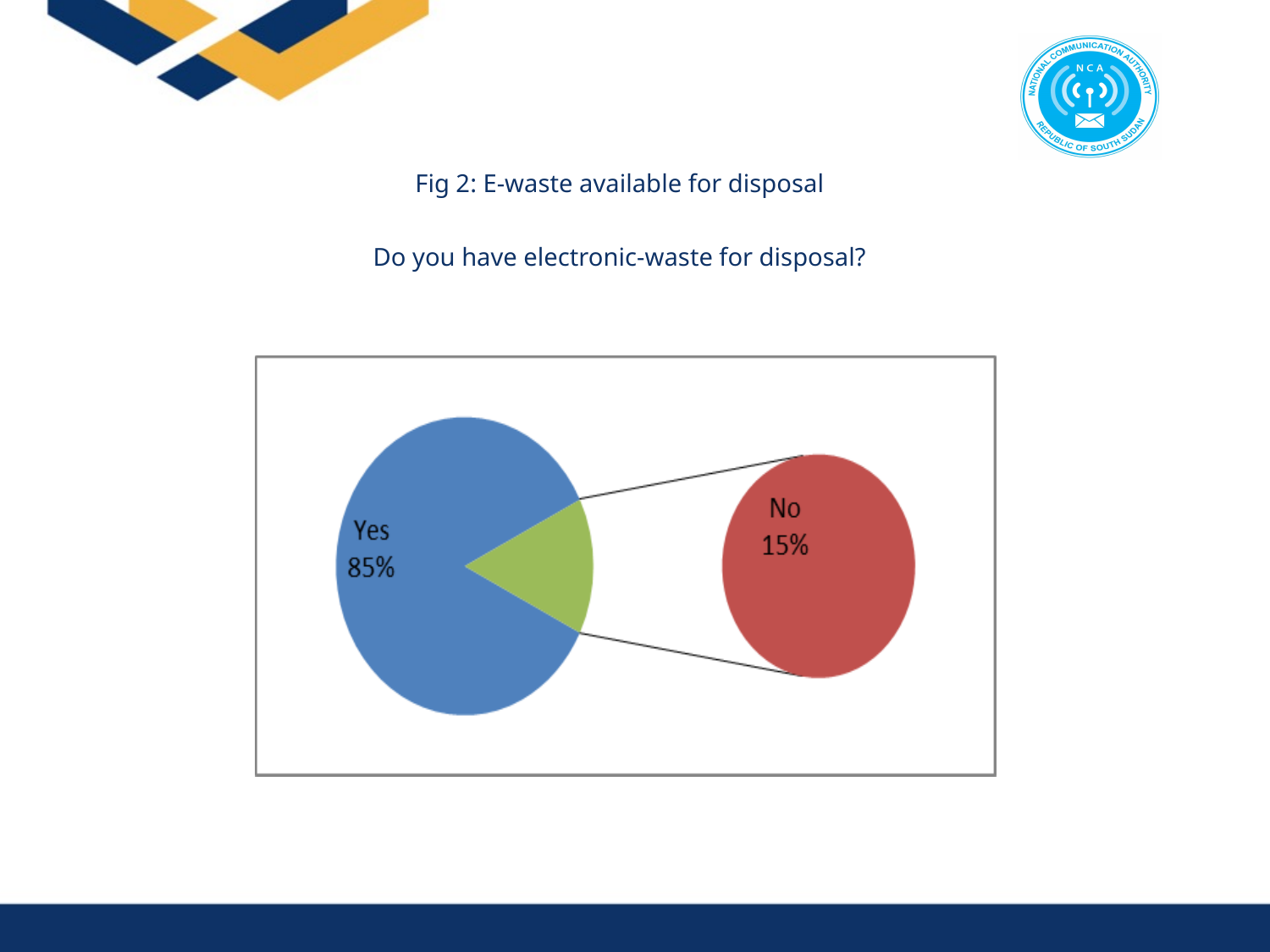
What share of the pie does the Yes slice represent? 85% What percentage of respondents answered No? 15% Which response has the largest share of the pie? Yes What is the figure caption above the chart? Fig 2: E-waste available for disposal What kind of chart is shown on the slide? pie chart How many categories are shown in the pie chart? 2 What percentage of respondents answered Yes? 85% Which response has the smallest share of the pie? No What is the difference in percentage points between the Yes and No responses? 70 What question does the chart answer? Do you have electronic-waste for disposal? Which is larger, the share for Yes or the share for No? Yes